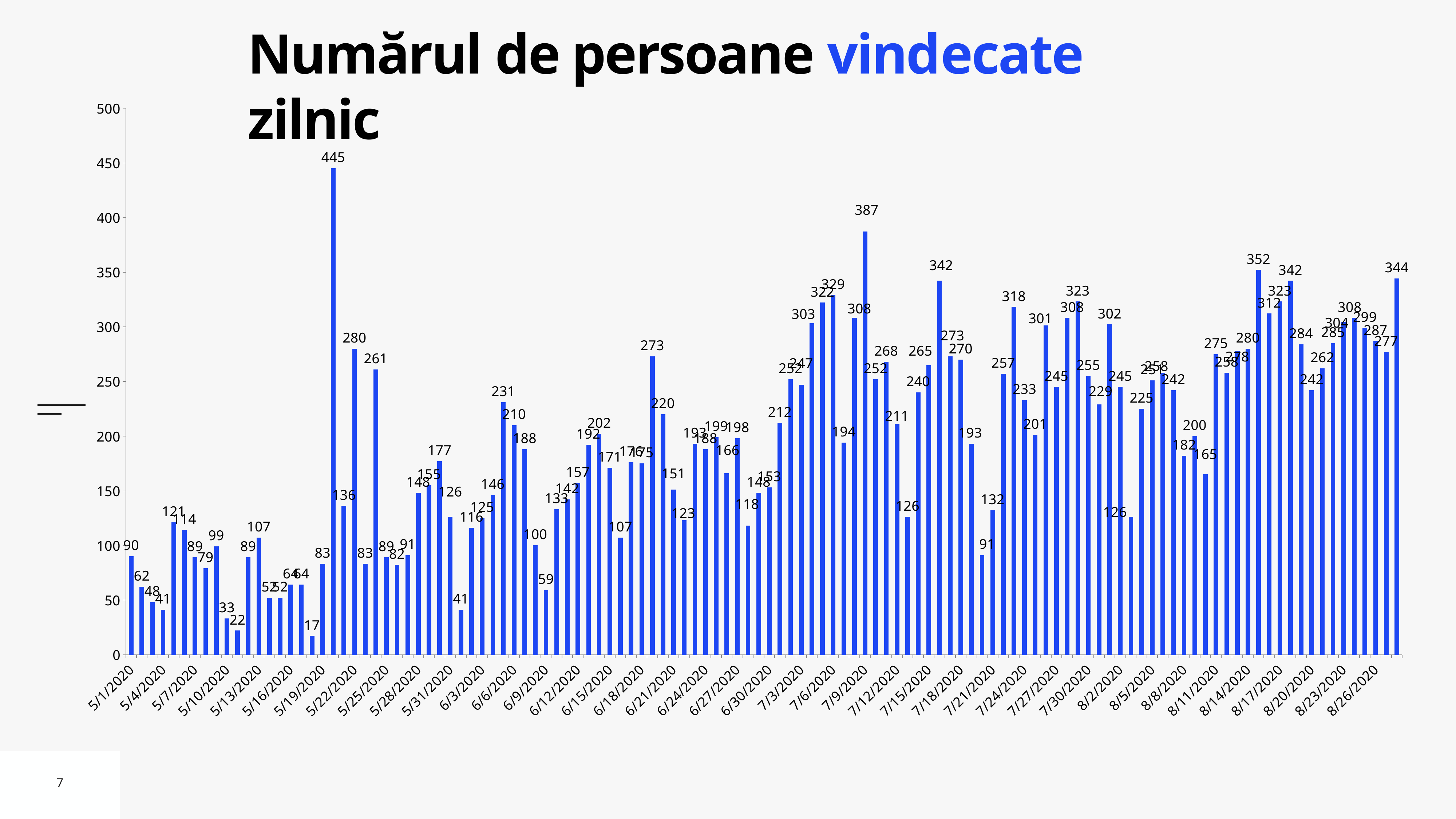
What is the lowest daily value shown in the chart? 17 What is the value of the first bar, for 5/1/2020? 90 What is the highest daily value shown in the chart? 445 What is the value of the last bar in the chart? 344 Is the value of the last bar greater or less than 300? greater What is the difference between the highest value (445) and the second-highest value (387)? 58 Is the value of the first bar (5/1/2020) greater or less than 100? less What is the title of the chart? Numărul de persoane vindecate zilnic Overall, do the daily values rise or fall from May to August along the x axis? rise What kind of chart is shown on the slide? bar chart What is the second-highest value labelled in the chart? 387 Which is larger, the value of the first bar (5/1/2020) or the value of the last bar? the last bar